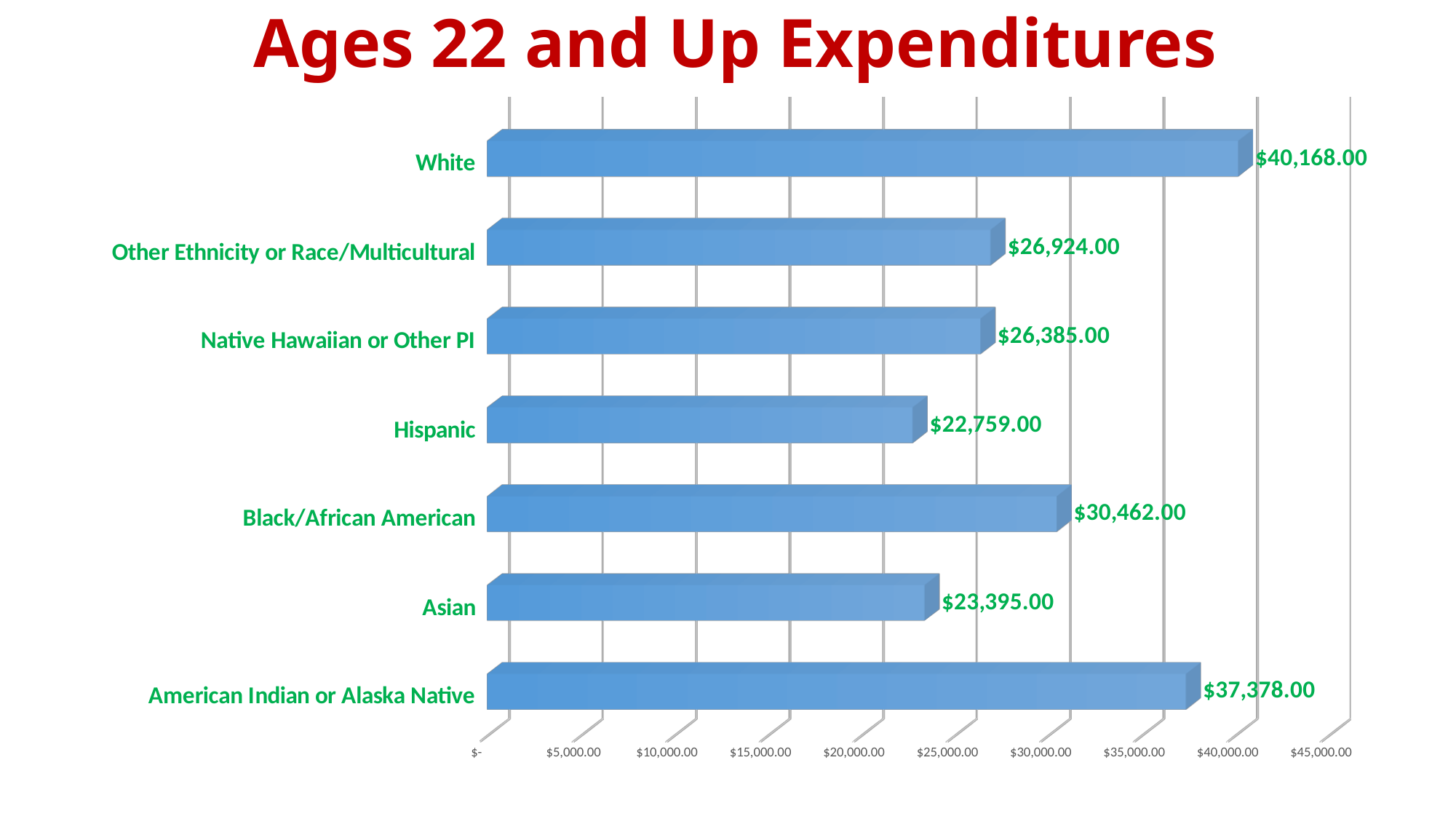
Is the value for Other Ethnicity or Race/Multicultural greater or less than $25,000.00? greater What is the difference between the expenditures for White and Black/African American? $9,706.00 What is the difference between the expenditures for Asian and Hispanic? $636.00 How many categories are shown in the chart? 7 Which category has the highest expenditure? White What is the expenditure value for American Indian or Alaska Native? $37,378.00 What is the expenditure value for Native Hawaiian or Other PI? $26,385.00 Which is larger, the expenditure for Black/African American or for Asian? Black/African American What is the expenditure value for White? $40,168.00 Which category has the lowest expenditure? Hispanic What kind of chart is shown on the slide? Bar chart What is the expenditure value for Hispanic? $22,759.00